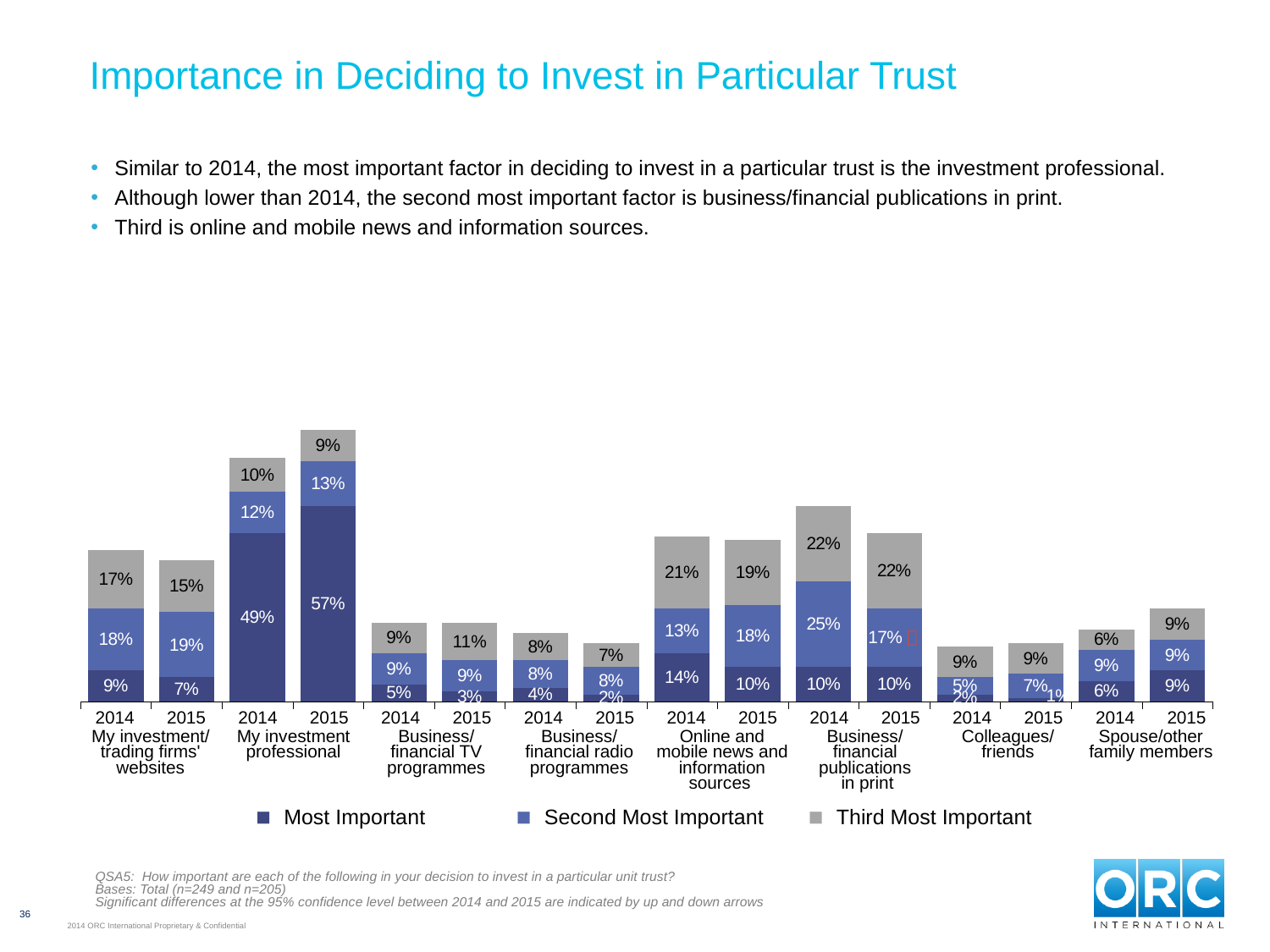
What is the total of the stacked bar for My investment professional in 2015? 79% What type of chart is shown on the slide? Stacked bar chart Which bar has the highest Most Important value? My investment professional 2015 What is the Second Most Important value for Business/financial publications in print in 2014? 25% How many series does the legend list? 3 What is the difference between the Most Important values for My investment professional in 2015 and 2014? 8% What is the Most Important value for My investment professional in 2015? 57% How many factor categories are shown on the x axis? 8 What is the Third Most Important value for Online and mobile news and information sources in 2014? 21% What colour represents the Third Most Important series? Grey Which is larger: the Second Most Important value for Online and mobile news and information sources in 2015 or in 2014? 2015 What is the total of the stacked bar for Business/financial publications in print in 2014? 57%